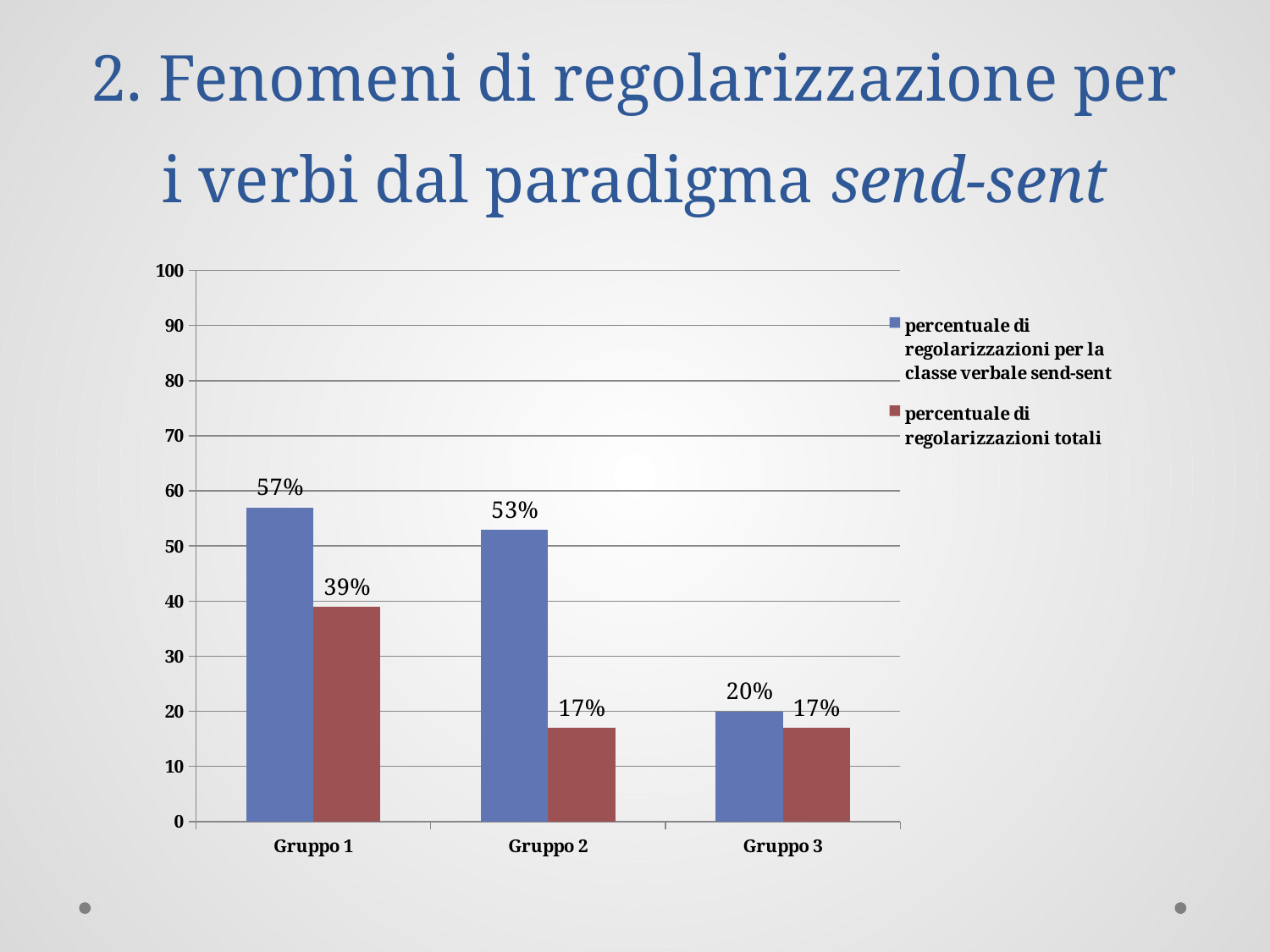
What kind of chart is shown on the slide? bar chart What is the value for Gruppo 2 in the series 'percentuale di regolarizzazioni totali'? 17% Do the values of the series 'percentuale di regolarizzazioni per la classe verbale send-sent' rise or fall from Gruppo 1 to Gruppo 3? fall Which group has the lowest value in the series 'percentuale di regolarizzazioni per la classe verbale send-sent'? Gruppo 3 Which is larger for Gruppo 1: 'percentuale di regolarizzazioni per la classe verbale send-sent' or 'percentuale di regolarizzazioni totali'? percentuale di regolarizzazioni per la classe verbale send-sent How many groups are shown on the x axis? 3 What is the value for Gruppo 3 in the series 'percentuale di regolarizzazioni per la classe verbale send-sent'? 20% What is the value for Gruppo 1 in the series 'percentuale di regolarizzazioni per la classe verbale send-sent'? 57% What is the difference between the two series' values for Gruppo 2? 36% What is the difference between the two series' values for Gruppo 1? 18% How many series does the legend list? 2 Which group has the highest value in the series 'percentuale di regolarizzazioni per la classe verbale send-sent'? Gruppo 1